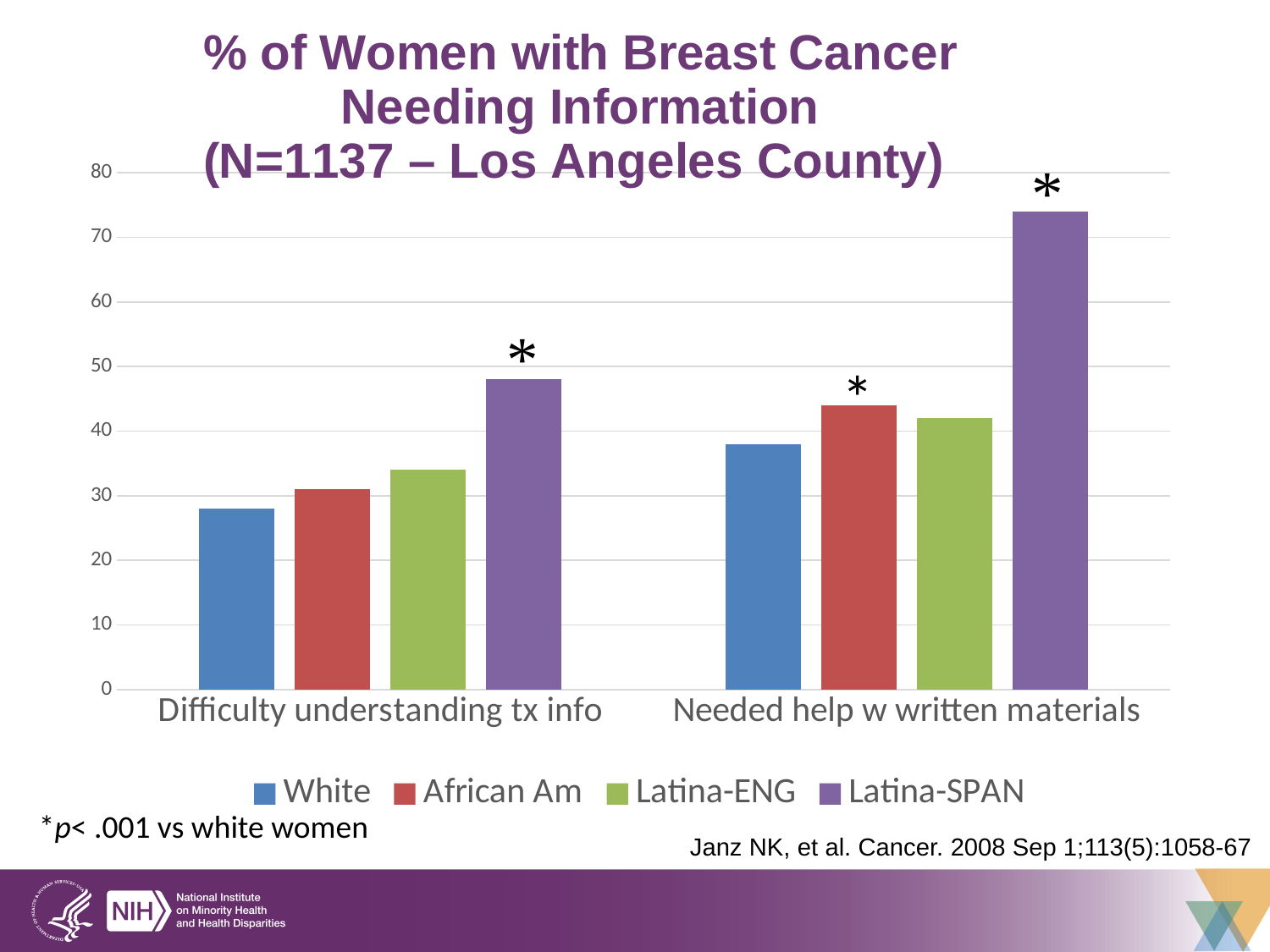
What colour are the Latina-SPAN bars? purple What kind of chart is shown on the slide? bar chart Is the value for Latina-SPAN in 'Difficulty understanding tx info' greater or less than 40? greater Which group has the highest value for 'Needed help w written materials'? Latina-SPAN How many series does the legend list? 4 Which is larger for 'Difficulty understanding tx info': White or Latina-ENG? Latina-ENG Is the value for Latina-SPAN in 'Needed help w written materials' greater or less than 70? greater Is the value for White in 'Difficulty understanding tx info' greater or less than 30? less Which group has the lowest value for 'Difficulty understanding tx info'? White How many categories are shown on the x axis? 2 Which group has the lowest value for 'Needed help w written materials'? White Which is larger: the Latina-SPAN value for 'Difficulty understanding tx info' or the Latina-SPAN value for 'Needed help w written materials'? Needed help w written materials